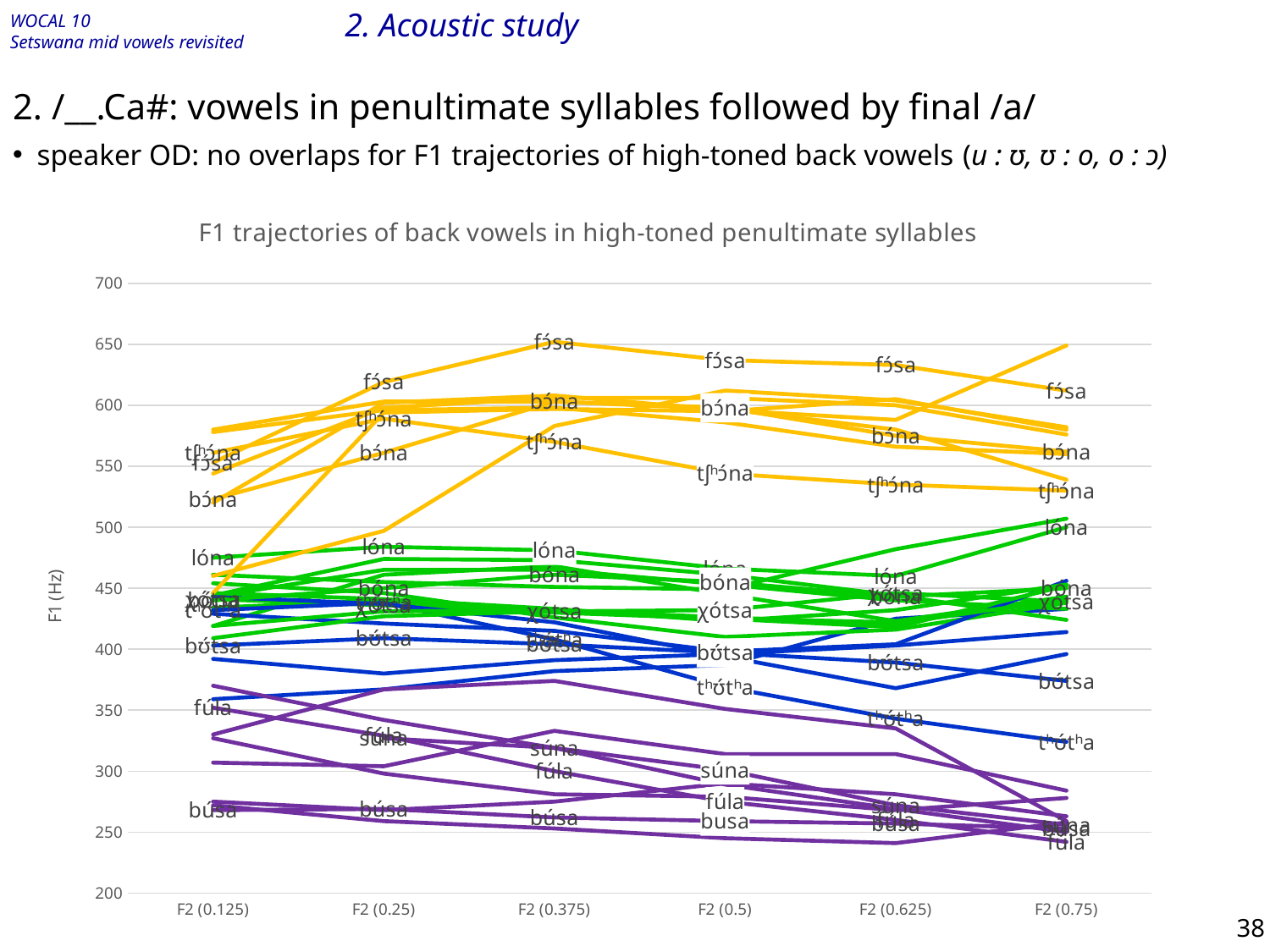
What is the label of the vertical axis of the chart? F1 (Hz) Is the value for fúla at F2 (0.75) greater or less than 300? less What kind of chart is shown on the slide? line chart At F2 (0.375), which is larger: the value for fɔ́sa or the value for búsa? fɔ́sa How many F2 time points are shown along the x axis of the chart? 6 Is the value for búsa at F2 (0.125) greater or less than 300? less What is the title of the chart? F1 trajectories of back vowels in high-toned penultimate syllables Is the value for tʃʰɔ́na at F2 (0.5) greater or less than 500? greater